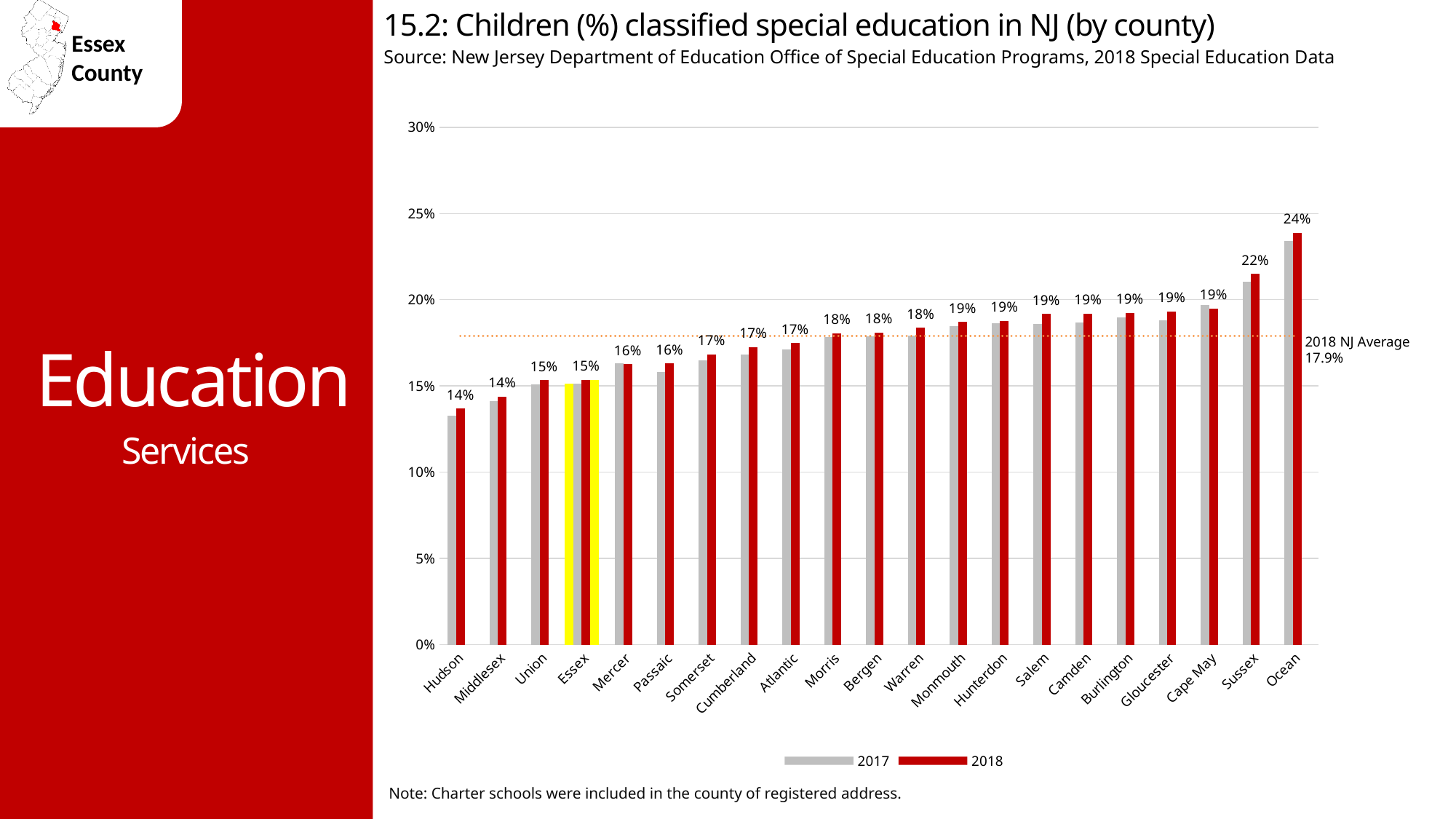
What is the 2018 value for Sussex county? 22% Is the 2017 value for Hudson greater or less than 15%? less What is the difference between the 2018 values for Ocean and Essex? 9 percentage points How many series does the legend list? 2 How many counties are shown on the x axis? 21 What kind of chart is shown on the slide? bar chart What is the 2018 value for Ocean county? 24% What is the 2018 NJ average shown by the dotted line? 17.9% Which county has the highest percentage of children classified special education in 2018? Ocean Which has a higher 2018 value, Sussex or Cape May? Sussex Which county has the lowest percentage of children classified special education in 2018? Hudson What is the 2018 value for Essex county? 15%